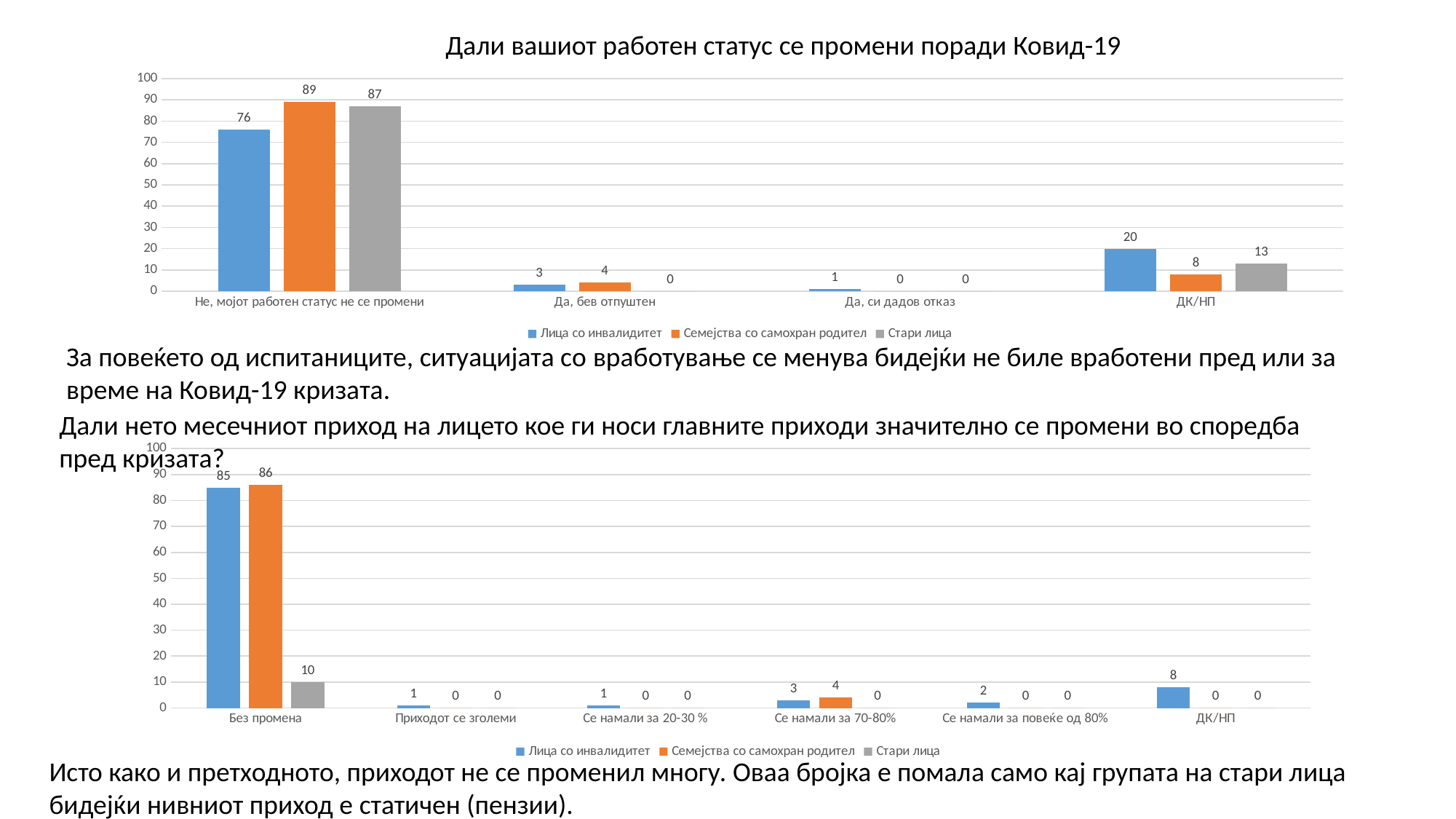
In the top chart, which series has the highest value in the category 'Не, мојот работен статус не се промени'? Семејства со самохран родител In the top chart, what is the value for Лица со инвалидитет in the category 'ДК/НП'? 20 In the top chart, how many series does the legend list? 3 In the top chart, what is the difference between Семејства со самохран родител and Лица со инвалидитет in the category 'Не, мојот работен статус не се промени'? 13 In the bottom chart, what is the value for Семејства со самохран родител in the category 'Се намали за 70-80%'? 4 In the top chart, what is the value for Стари лица in the category 'Не, мојот работен статус не се промени'? 87 In the bottom chart, how many categories are shown on the x axis? 6 What is the title of the top chart? Дали вашиот работен статус се промени поради Ковид-19 What type of chart is the top chart? Bar chart In the top chart, how many categories are shown on the x axis? 4 In the bottom chart, what is the value for Стари лица in the category 'Без промена'? 10 In the bottom chart, which is larger in the category 'ДК/НП': Лица со инвалидитет or Стари лица? Лица со инвалидитет